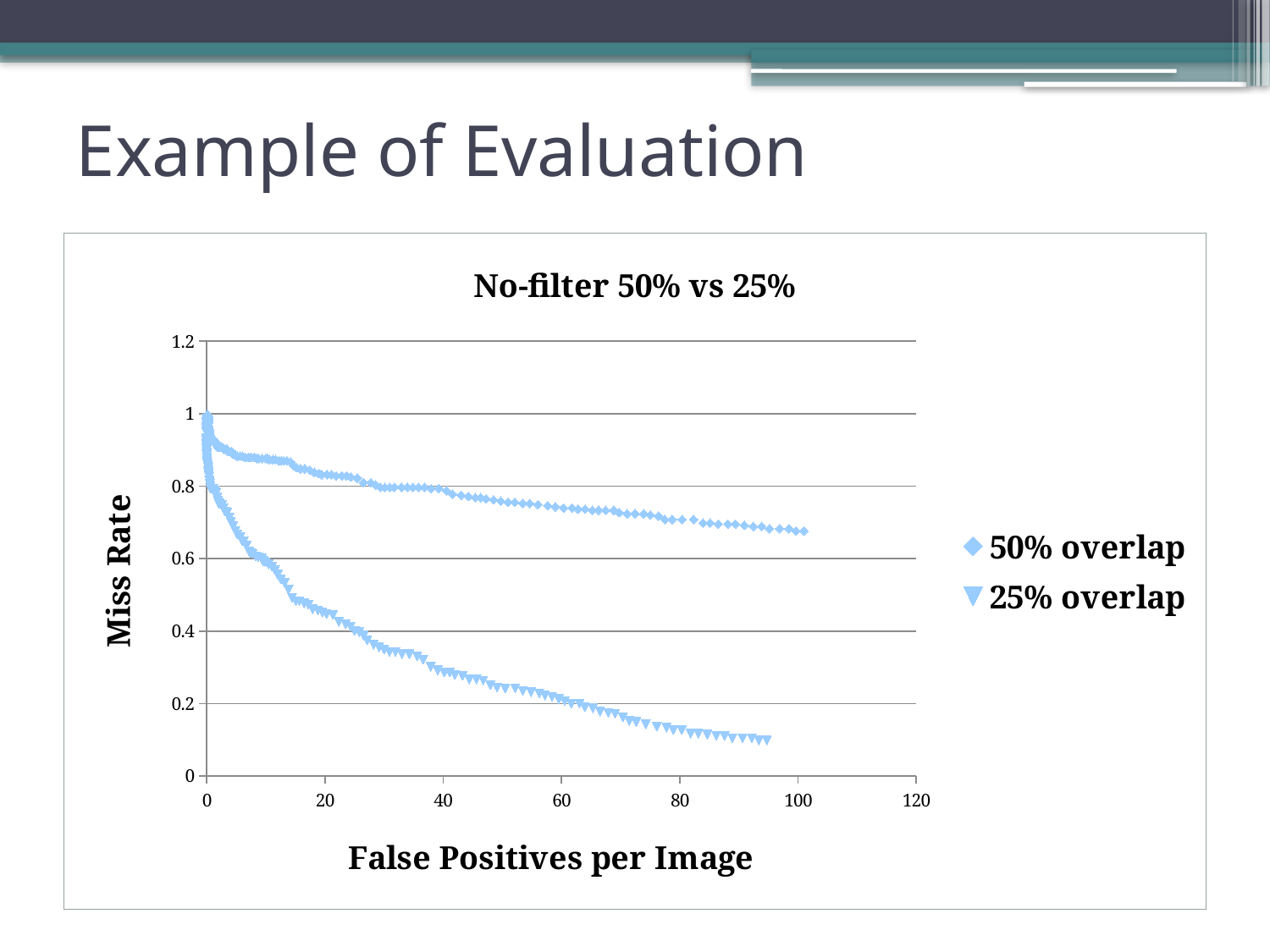
What is the title of the chart? No-filter 50% vs 25% Is the miss rate for the 25% overlap series at 80 false positives per image greater or less than 0.2? less Which series has the higher miss rate at 40 false positives per image, 50% overlap or 25% overlap? 50% overlap Is the miss rate for the 25% overlap series at 40 false positives per image greater or less than 0.4? less Does the miss rate for the 25% overlap series rise or fall as false positives per image increase? fall What is the label of the y axis? Miss Rate How many series does the legend list? 2 Does the miss rate for the 50% overlap series rise or fall as false positives per image increase? fall Is the miss rate for the 50% overlap series at 100 false positives per image greater or less than 0.8? less What kind of chart is shown on the slide? scatter chart Which series has the lower miss rate at 80 false positives per image? 25% overlap